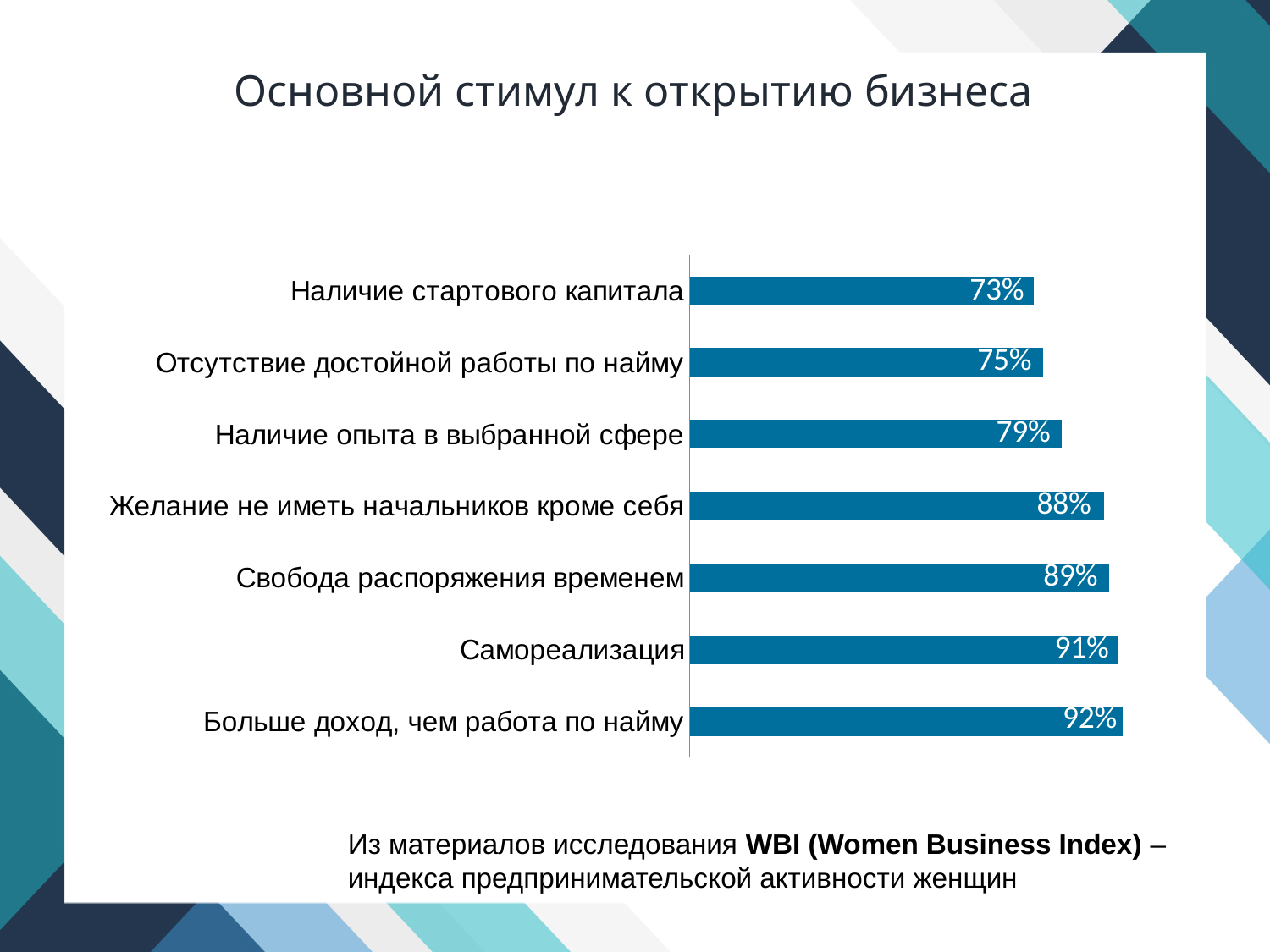
Which category has the lowest value? Наличие стартового капитала Which is larger: «Наличие опыта в выбранной сфере» or «Самореализация»? Самореализация What is the value for «Наличие опыта в выбранной сфере»? 79% What is the difference between «Больше доход, чем работа по найму» and «Наличие стартового капитала»? 19% What is the difference between «Свобода распоряжения временем» and «Отсутствие достойной работы по найму»? 14% What is the value for «Наличие стартового капитала»? 73% Which category has the highest value? Больше доход, чем работа по найму What is the value for «Самореализация»? 91% What is the value for «Желание не иметь начальников кроме себя»? 88% What kind of chart is shown on the slide? Bar chart What is the title of the slide? Основной стимул к открытию бизнеса How many categories are shown in the chart? 7